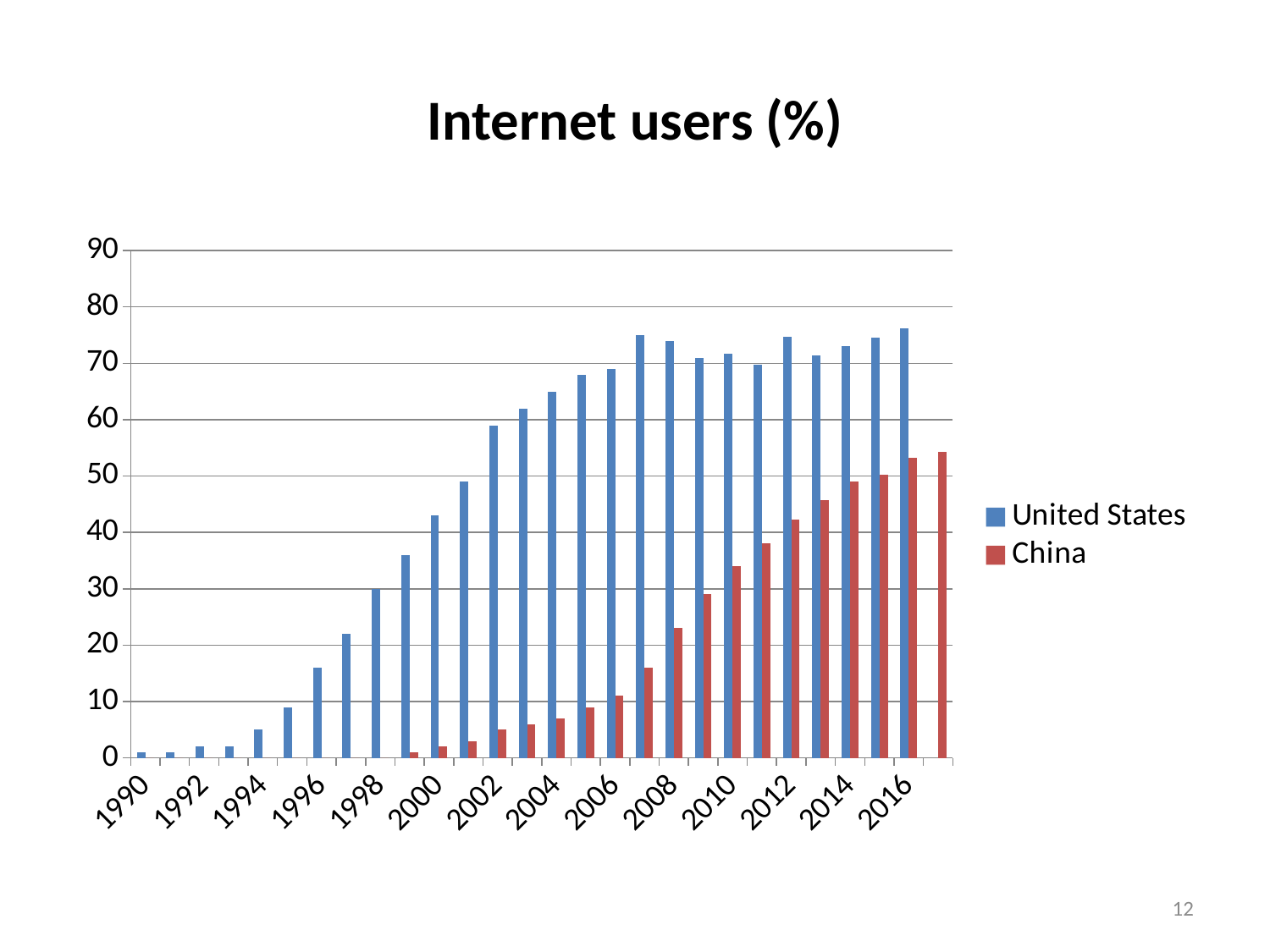
Do the values for China rise or fall from 2000 to 2016? rise In 2010, which series has the larger value, United States or China? United States How many series does the legend list? 2 Is the value for China in 2008 greater or less than 20? greater What colour are the bars for China? red Which two series are shown in the legend? United States and China Is the value for United States in 2000 greater or less than 40? greater Is the value for United States in 2016 greater or less than 70? greater What kind of chart is shown on the slide? bar chart